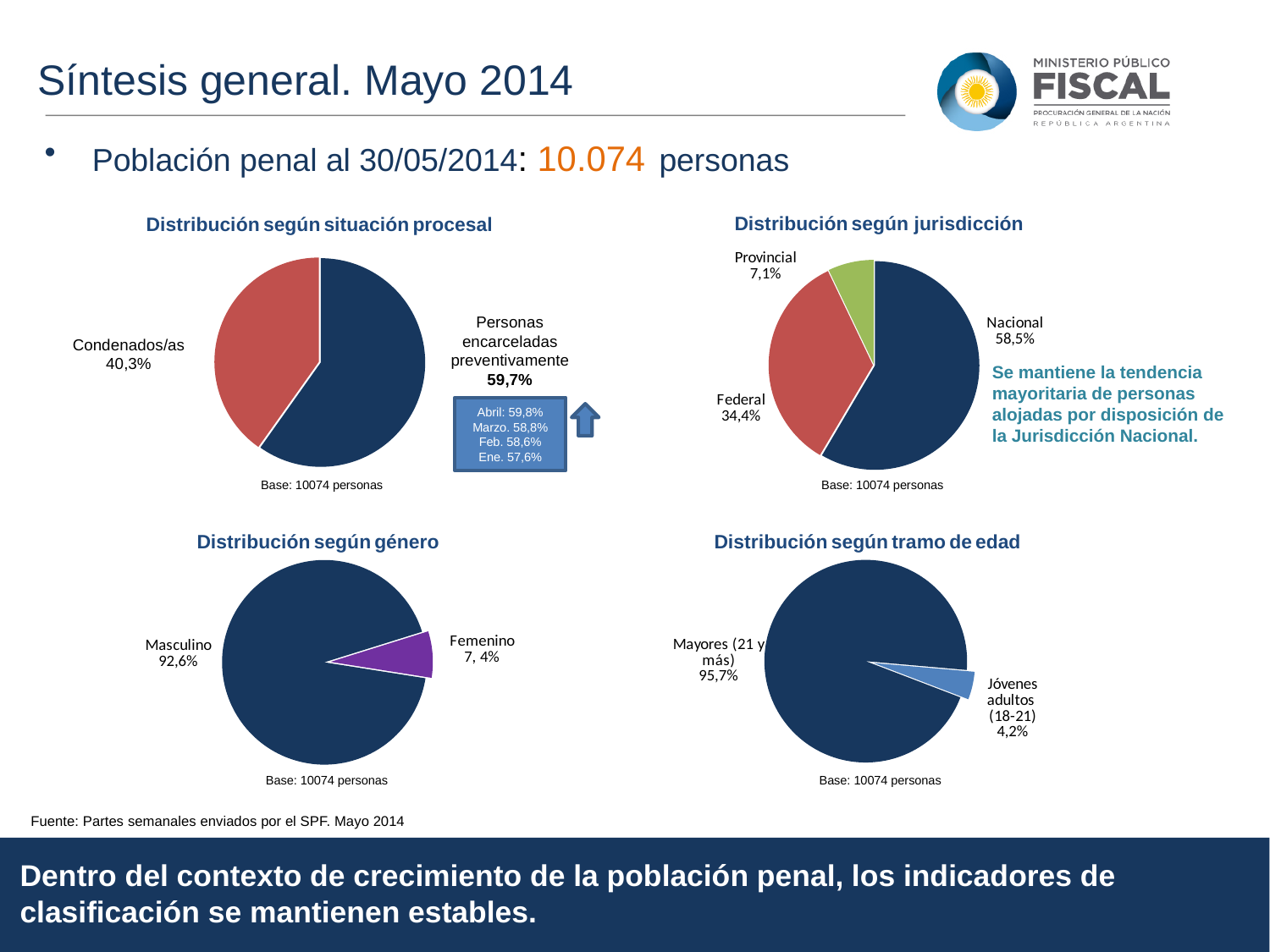
What base (number of persons) is stated below the 'Distribución según situación procesal' chart? 10074 personas In the 'Distribución según jurisdicción' chart, which category has the smallest slice? Provincial In the 'Distribución según jurisdicción' chart, what share is labelled for Federal? 34,4% In the 'Distribución según jurisdicción' chart, how many categories are shown? 3 In the 'Distribución según jurisdicción' chart, which category has the largest slice? Nacional In the 'Distribución según jurisdicción' chart, what is the difference in percentage points between Nacional and Federal? 24,1 In the 'Distribución según situación procesal' chart, what share is labelled for Personas encarceladas preventivamente? 59,7% In the 'Distribución según tramo de edad' chart, which category is larger, Mayores (21 y más) or Jóvenes adultos (18-21)? Mayores (21 y más) In the 'Distribución según tramo de edad' chart, what share is labelled for Jóvenes adultos (18-21)? 4,2% In the 'Distribución según género' chart, what share is labelled for Masculino? 92,6% What type of chart is used for 'Distribución según género'? Pie chart In the 'Distribución según situación procesal' chart, what share is labelled for Condenados/as? 40,3%